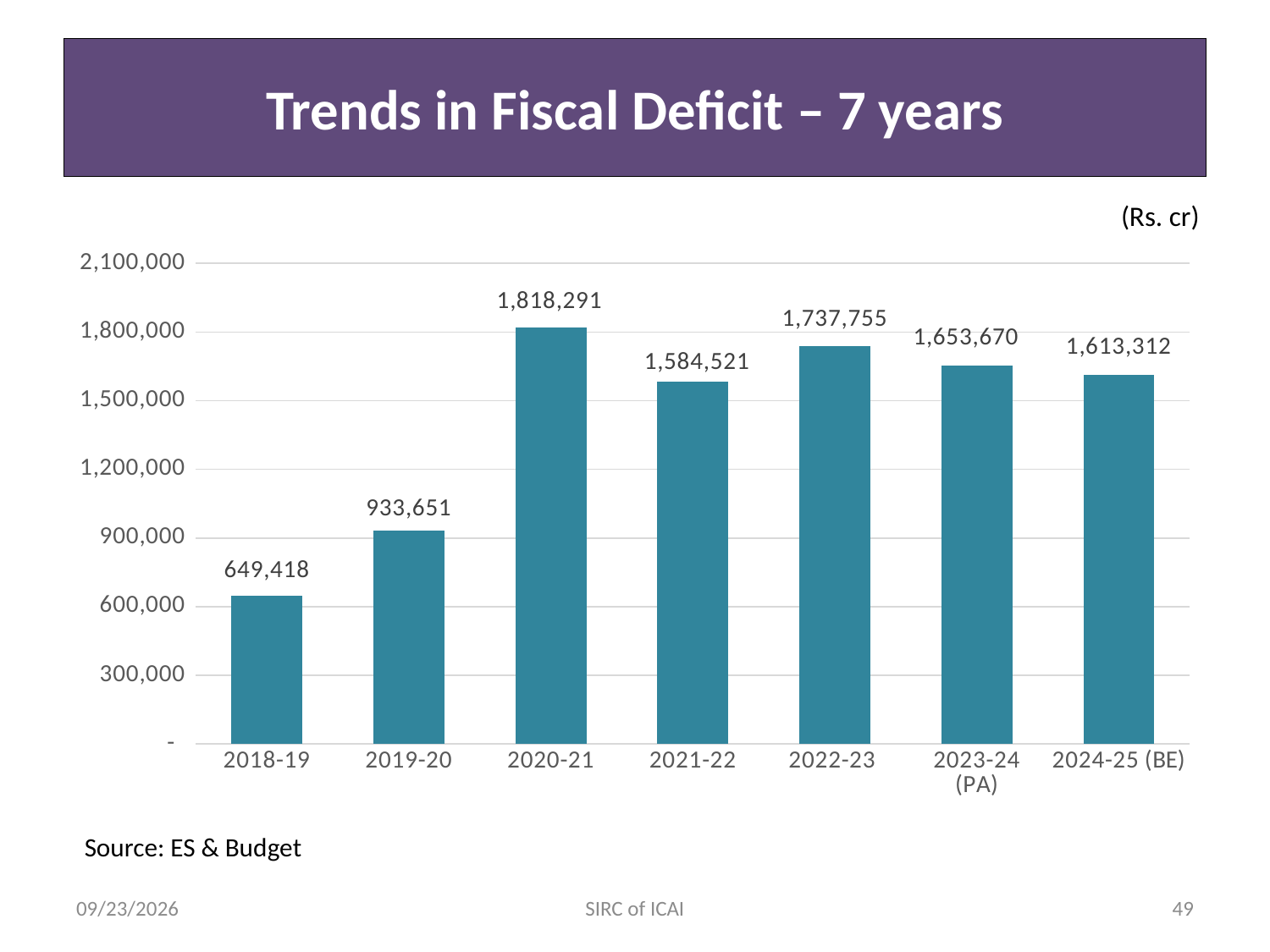
Which is larger, the fiscal deficit for 2023-24 (PA) or for 2024-25 (BE)? 2023-24 (PA) What unit is indicated for the values on the chart? Rs. cr What is the fiscal deficit value for 2018-19? 649,418 How many years are shown on the chart? 7 What is the fiscal deficit value for 2024-25 (BE)? 1,613,312 What kind of chart is shown on the slide? bar chart Which year has the lowest fiscal deficit? 2018-19 What is the difference between the fiscal deficit in 2022-23 and 2021-22? 153,234 What is the fiscal deficit value for 2020-21? 1,818,291 Is the value for 2021-22 greater or less than 1,500,000? greater Which year has the highest fiscal deficit? 2020-21 What is the difference between the fiscal deficit in 2019-20 and 2018-19? 284,233